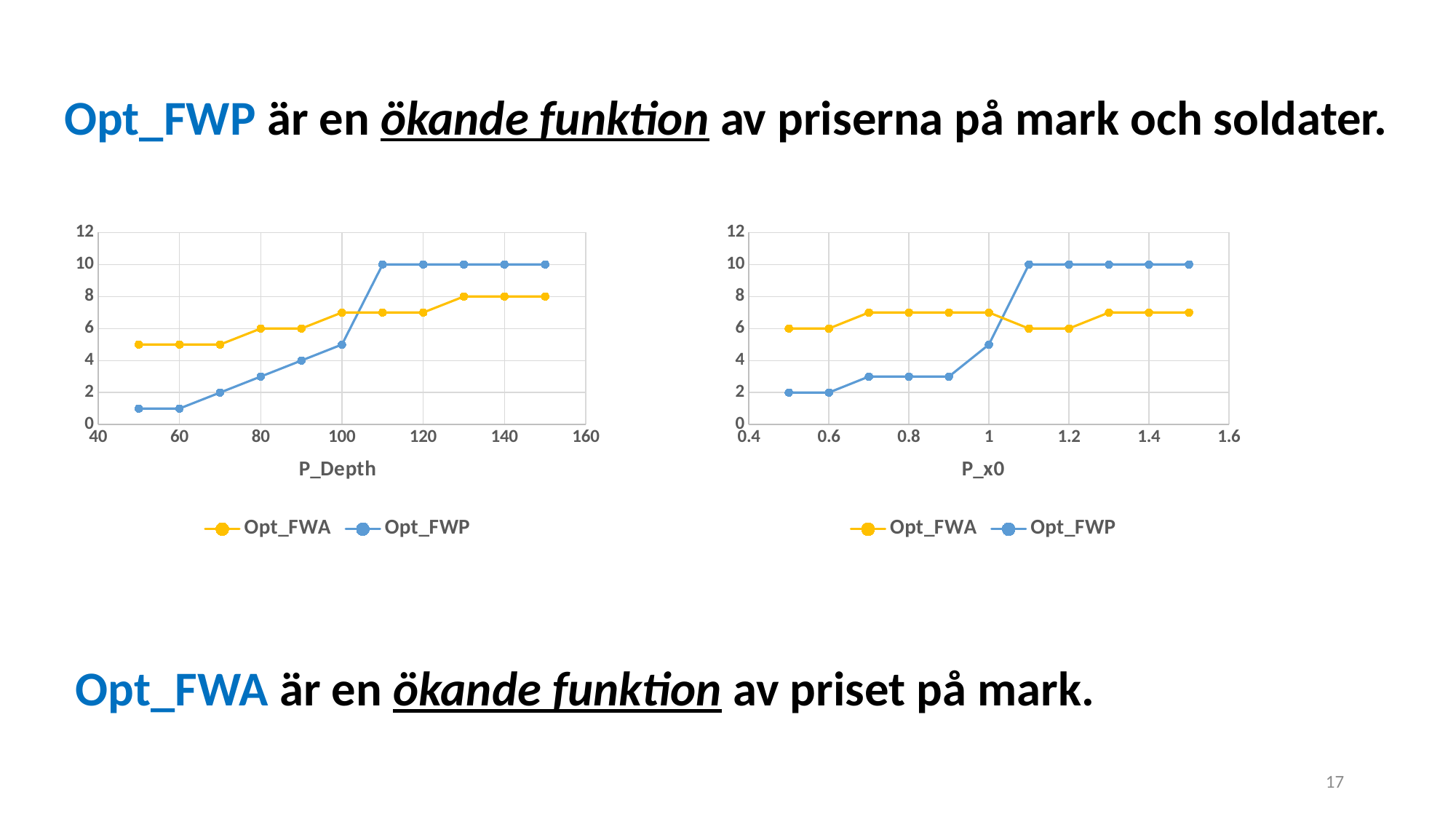
In the left chart (P_Depth), what is the value of Opt_FWA at P_Depth = 140? 8 In the left chart (P_Depth), is the value of Opt_FWP at P_Depth = 100 greater or less than 6? less In the left chart (P_Depth), what is the value of Opt_FWA at P_Depth = 80? 6 In the left chart (P_Depth), does Opt_FWP rise or fall as P_Depth increases? rise In the right chart (P_x0), what is the value of Opt_FWP at P_x0 = 1.2? 10 How many series does the legend of the left chart (P_Depth) list? 2 What kind of chart is the right chart (P_x0)? line chart In the left chart (P_Depth), what is the difference between Opt_FWP and Opt_FWA at P_Depth = 140? 2 In the right chart (P_x0), what is the value of Opt_FWA at P_x0 = 1.2? 6 In the left chart (P_Depth), what is the value of Opt_FWP at P_Depth = 120? 10 In the right chart (P_x0), what is the value of Opt_FWP at P_x0 = 0.6? 2 In the right chart (P_x0), which series has the larger value at P_x0 = 0.6, Opt_FWA or Opt_FWP? Opt_FWA